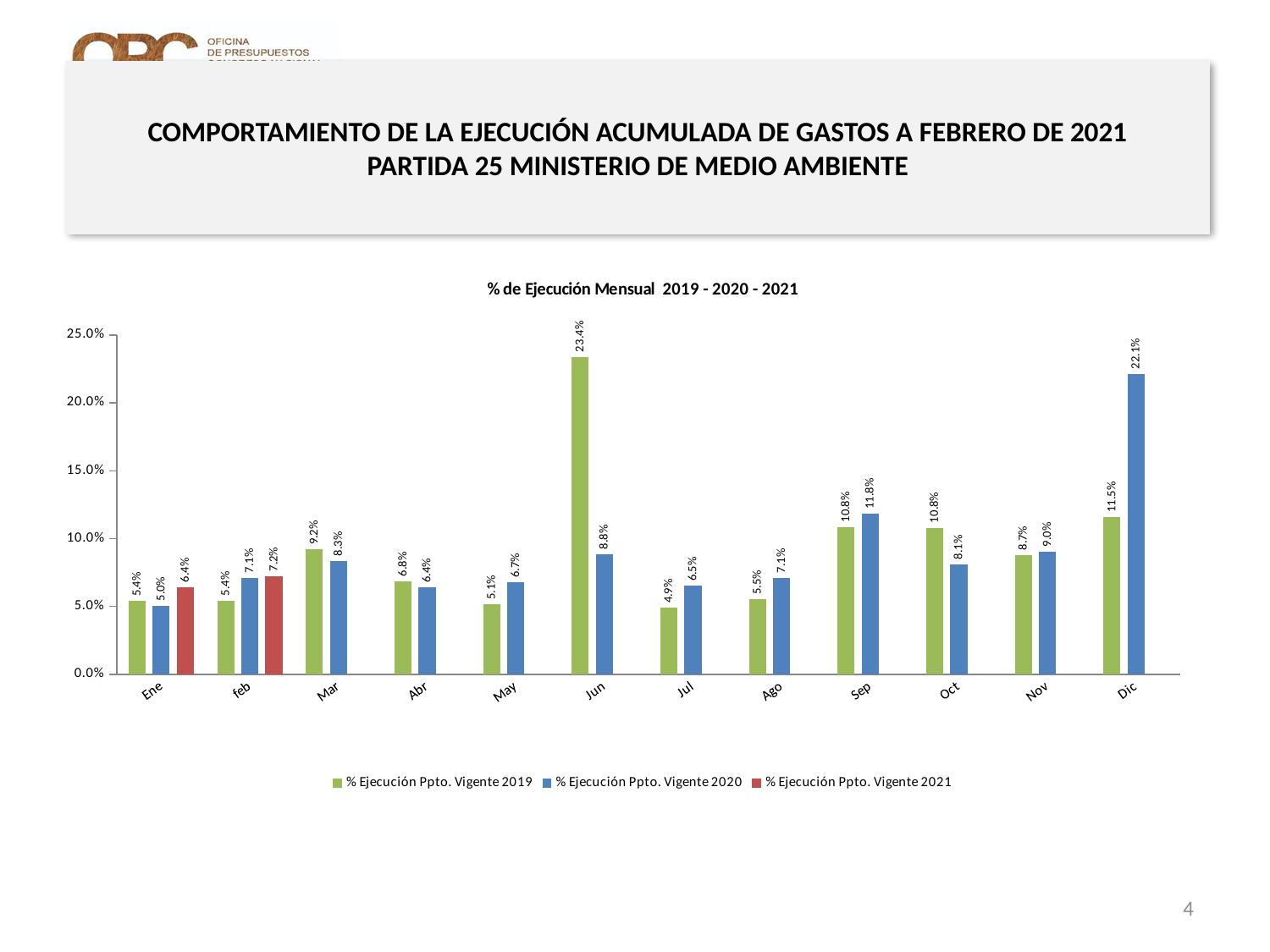
In which month is the % Ejecución Ppto. Vigente 2020 series lowest? Ene In which month is the % Ejecución Ppto. Vigente 2019 series highest? Jun Is the value for % Ejecución Ppto. Vigente 2020 in Dic greater or less than 20.0%? greater Which is larger in Sep: the 2019 value or the 2020 value? 2020 (11.8%) What is the difference between the 2019 and 2020 values in Jun? 14.6% How many series does the legend list? 3 What is the value for % Ejecución Ppto. Vigente 2021 in feb? 7.2% What is the title of the chart? % de Ejecución Mensual 2019 - 2020 - 2021 What is the value for % Ejecución Ppto. Vigente 2020 in Dic? 22.1% What is the value for % Ejecución Ppto. Vigente 2019 in Jun? 23.4% What kind of chart is shown on the slide? Bar chart How many months are shown on the x axis? 12